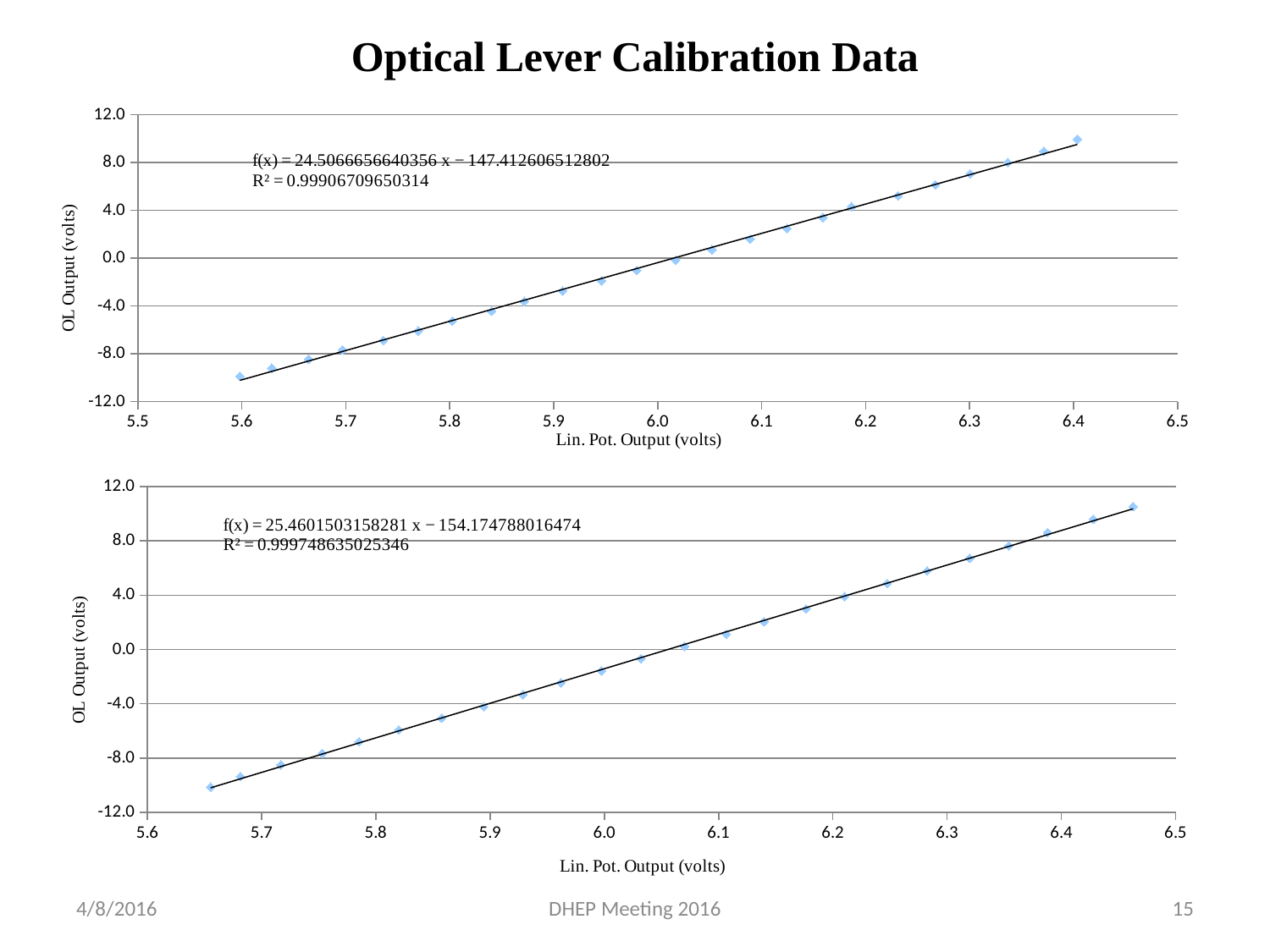
Which chart, top or bottom, shows the higher R² value? bottom What is the x-axis title of the top chart? Lin. Pot. Output (volts) What is the slope of the fitted line f(x) shown on the bottom chart? 25.4601503158281 What kind of chart is the top chart on the slide? scatter chart In the bottom chart, do the OL Output values rise or fall as Lin. Pot. Output increases? rise What is the y-axis title of the bottom chart? OL Output (volts) What R² value is printed on the bottom chart? 0.999748635025346 What is the intercept of the fitted line f(x) shown on the bottom chart? −154.174788016474 In the top chart, is the OL Output value of the rightmost data point greater or less than 8.0? greater What is the slope of the fitted line f(x) shown on the top chart? 24.5066656640356 In the bottom chart, is the OL Output value of the leftmost data point greater or less than -8.0? less What R² value is printed on the top chart? 0.99906709650314